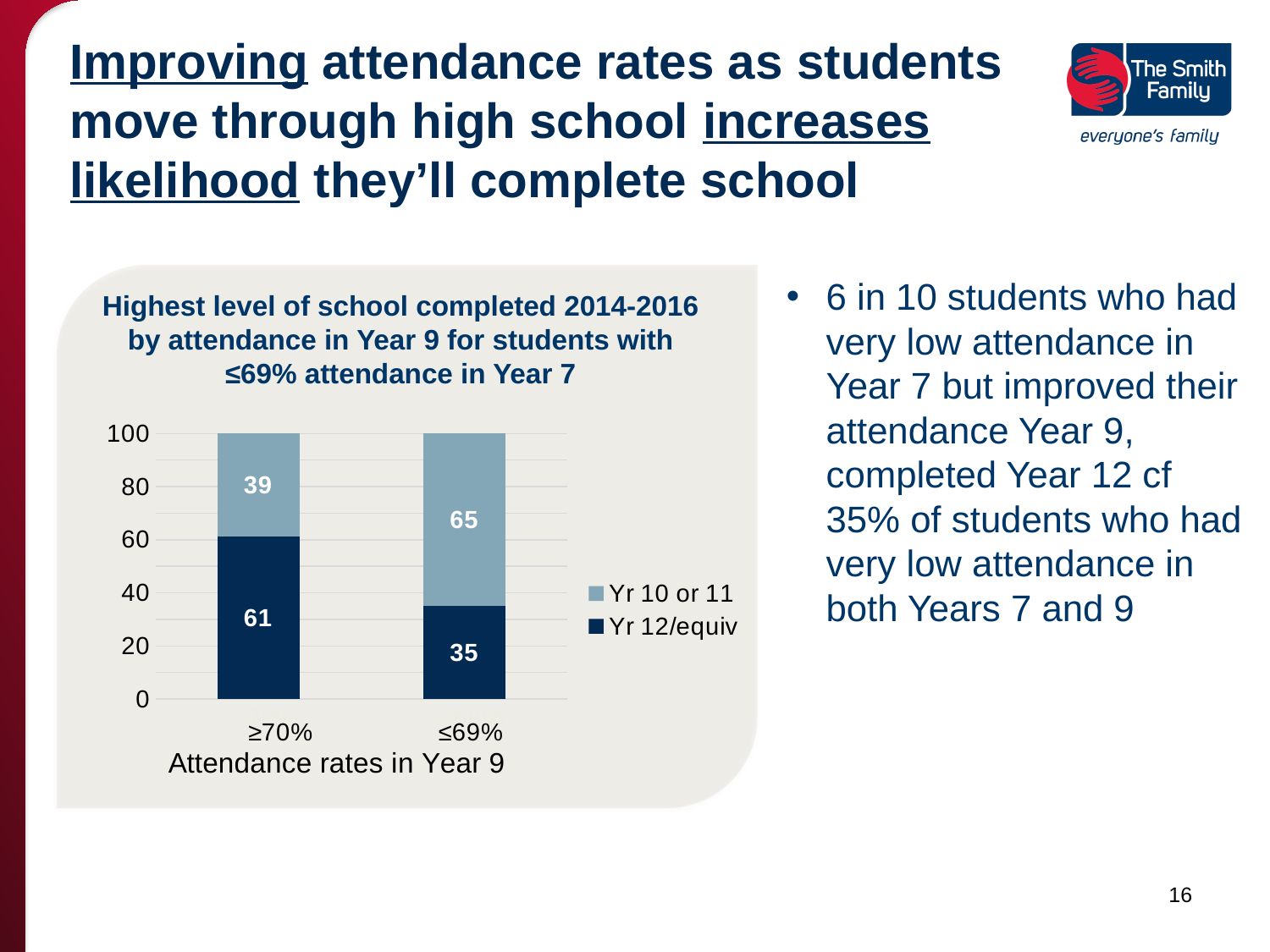
What is the difference between the Yr 12/equiv values for ≥70% and ≤69% attendance? 26 What is the x-axis title of the chart? Attendance rates in Year 9 What is the value for Yr 12/equiv in the ≤69% attendance category? 35 What is the value for Yr 10 or 11 in the ≥70% attendance category? 39 How many categories are shown on the x axis? 2 How many series does the legend list? 2 What kind of chart is shown on the slide? Stacked bar chart Which series is shown in the darker blue colour? Yr 12/equiv What is the value for Yr 12/equiv in the ≥70% attendance category? 61 What is the total of the stacked bar for the ≤69% attendance category? 100 What is the value for Yr 10 or 11 in the ≤69% attendance category? 65 Which attendance category has the higher Yr 12/equiv value? ≥70%